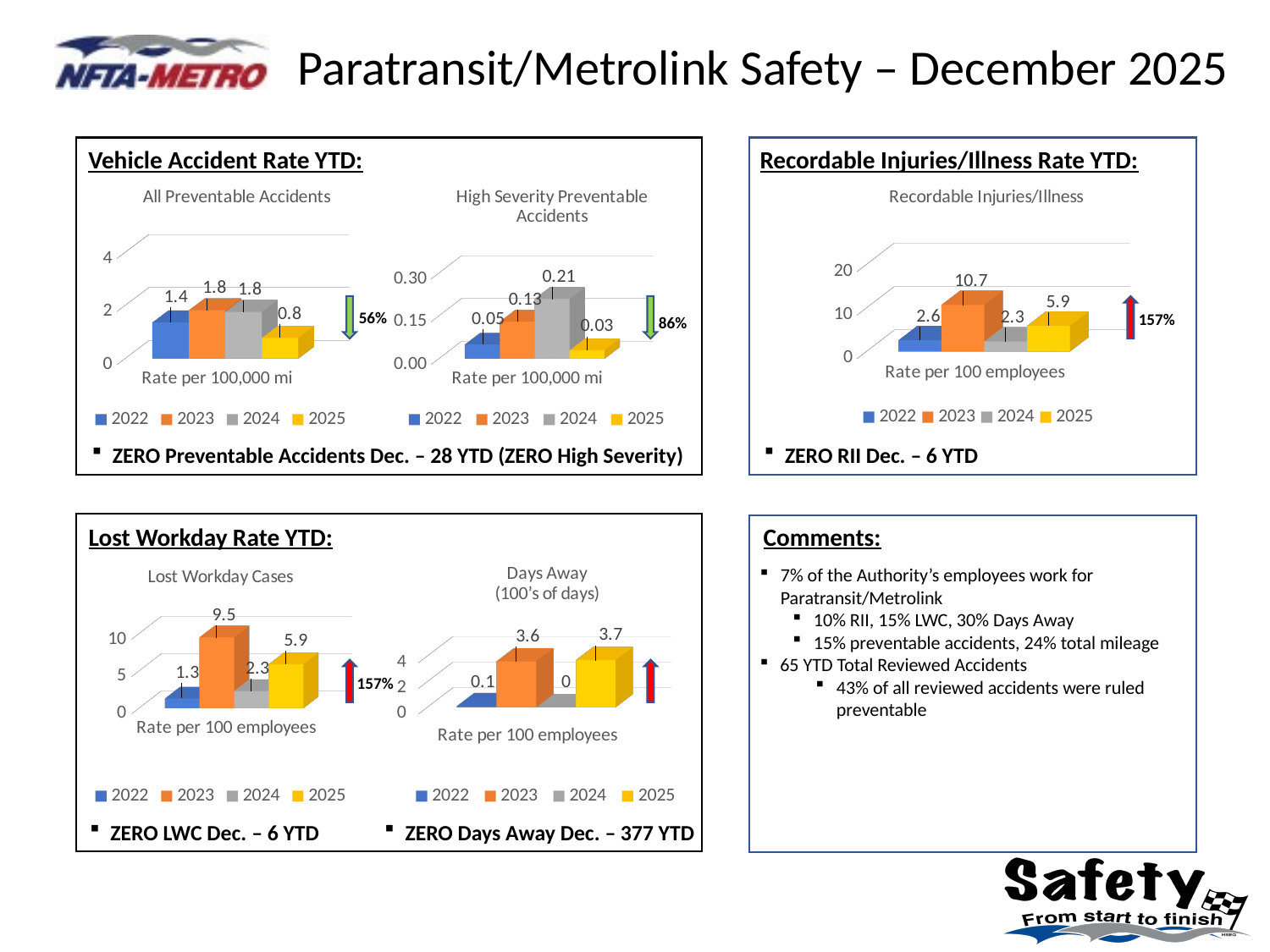
What is the x-axis category label shown under the "All Preventable Accidents" chart? Rate per 100,000 mi In the "High Severity Preventable Accidents" chart, what is the value for 2023? 0.13 How many series does the legend of the "Lost Workday Cases" chart list? 4 In the "All Preventable Accidents" chart, what is the value for 2025? 0.8 In the "Recordable Injuries/Illness" chart, which year has the lowest value? 2024 What kind of chart is the "Recordable Injuries/Illness" chart? Bar chart In the "Recordable Injuries/Illness" chart, what is the difference between the 2023 and 2025 values? 4.8 In the "Days Away (100's of days)" chart, what is the value for 2024? 0 In the "High Severity Preventable Accidents" chart, which year has the highest value? 2024 In the "Lost Workday Cases" chart, what is the value for 2023? 9.5 In the "Lost Workday Cases" chart, which is larger, the value for 2024 or the value for 2025? 2025 In the "Days Away (100's of days)" chart, which year has the highest value? 2025